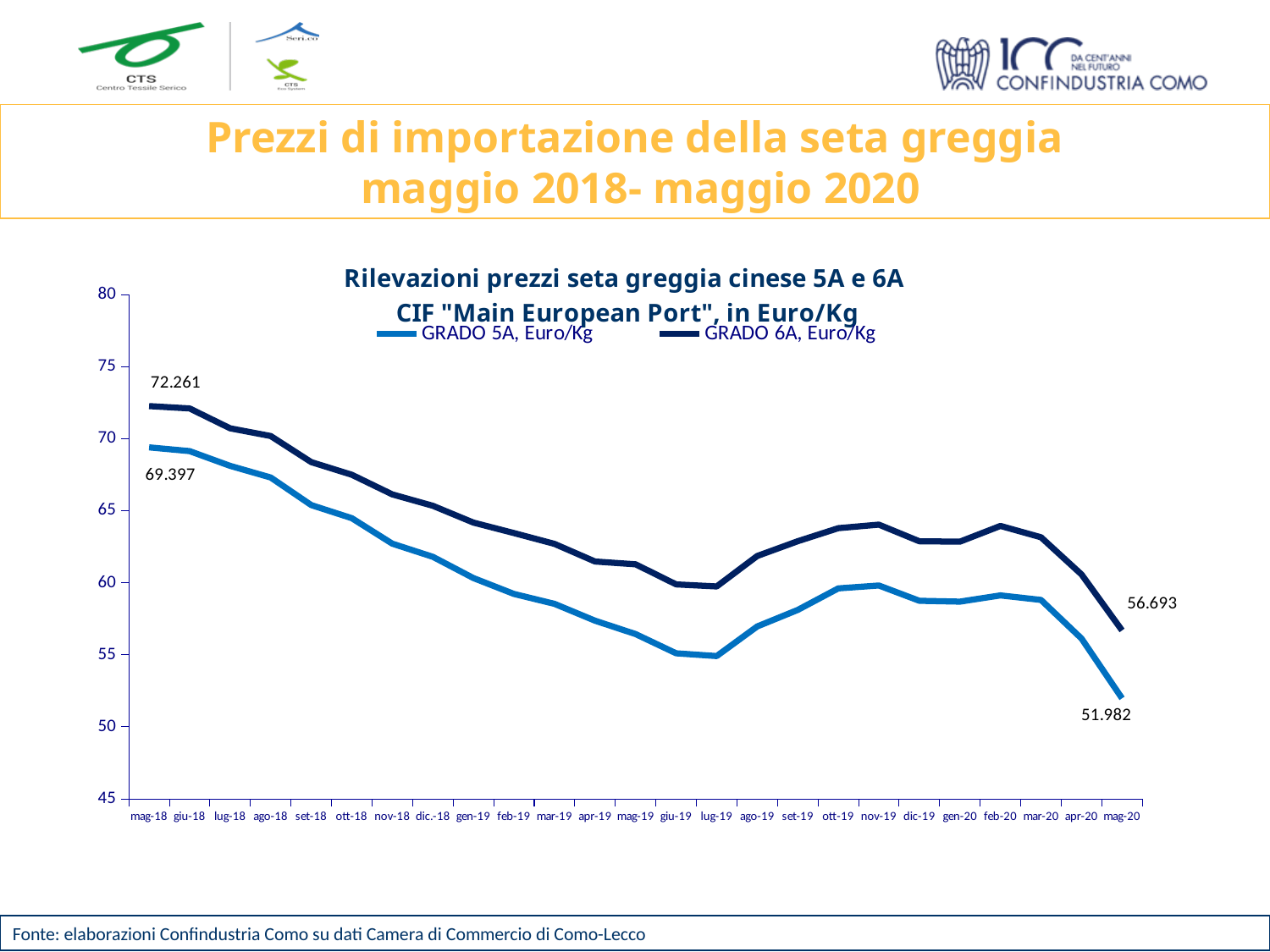
What is the difference between the GRADO 6A and GRADO 5A values in mag-18? 2.864 Overall, do the GRADO 5A values rise or fall from mag-18 to mag-20? fall What is the value of GRADO 6A, Euro/Kg in mag-20? 56.693 Which series has the higher value in mag-20, GRADO 5A or GRADO 6A? GRADO 6A, Euro/Kg How many series does the legend list? 2 What is the value of GRADO 5A, Euro/Kg in mag-20? 51.982 What type of chart is shown on the slide? line chart What is the value of GRADO 5A, Euro/Kg in mag-18? 69.397 What is the value of GRADO 6A, Euro/Kg in mag-18? 72.261 What is the difference between the GRADO 6A and GRADO 5A values in mag-20? 4.711 Is the value for GRADO 5A, Euro/Kg in giu-19 greater or less than 60? less How many months are plotted along the x axis? 25